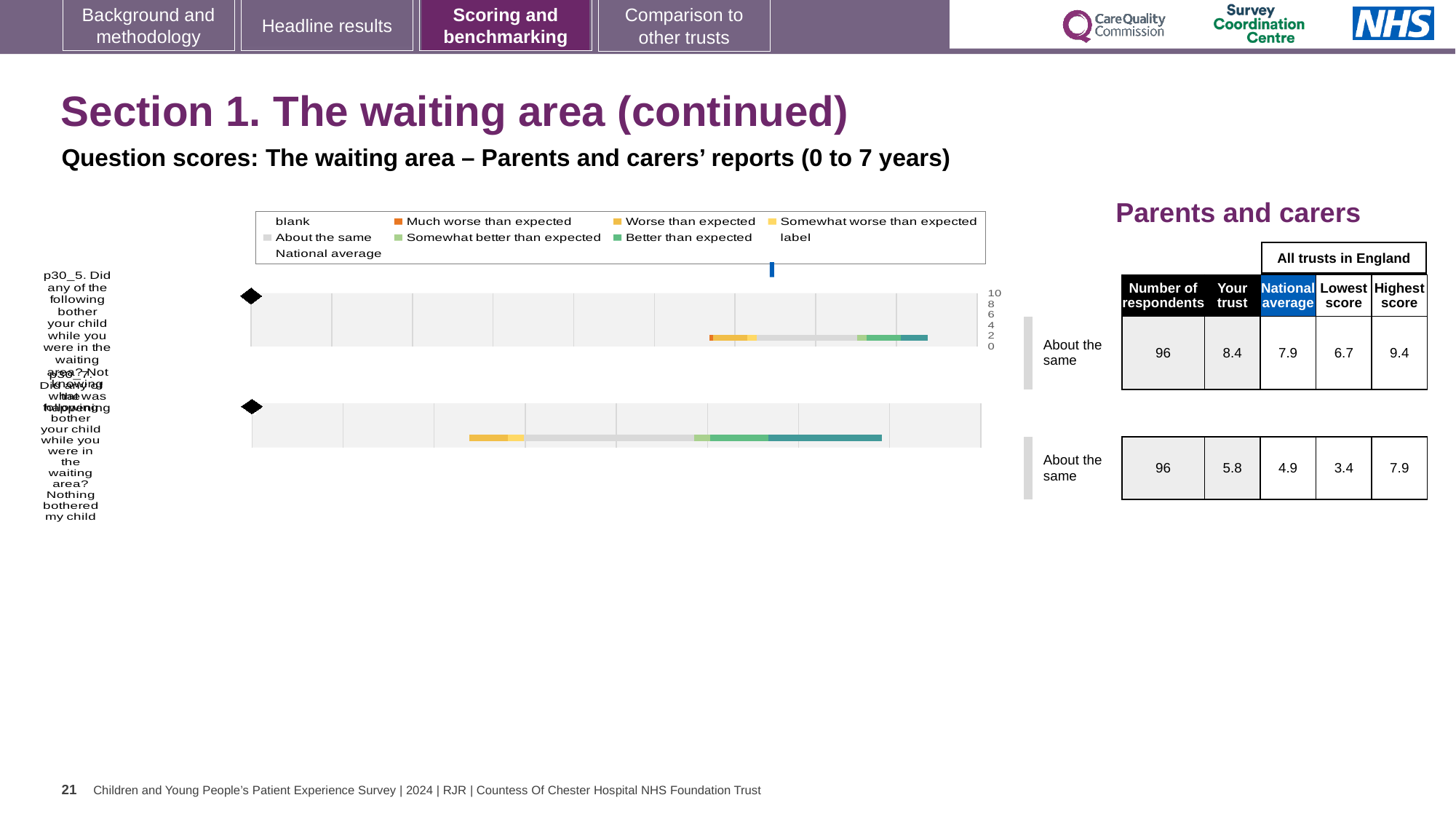
For the top chart (p30_5, Not knowing what was happening), what is the national average score shown in the table? 7.9 How many question bar charts are shown on the slide? 2 Which chart has the higher 'Your trust' score, the top chart (p30_5) or the bottom chart (p30_7)? the top chart (p30_5) What is the difference between the 'Your trust' score and the national average for the bottom chart (p30_7, Nothing bothered my child)? 0.9 For the bottom chart (p30_7, Nothing bothered my child), what is the lowest score across all trusts in England? 3.4 For the bottom chart (p30_7, Nothing bothered my child), what is the 'Your trust' score shown in the table? 5.8 Which legend entry is shown in orange? Much worse than expected For the top chart (p30_5, Not knowing what was happening), what is the 'Your trust' score shown in the table? 8.4 For the bottom chart (p30_7, Nothing bothered my child), what is the highest score across all trusts in England? 7.9 What is the maximum value shown on the chart's axis? 10 How many entries does the chart legend list? 9 What kind of chart is used for the two question rows on the slide? bar chart